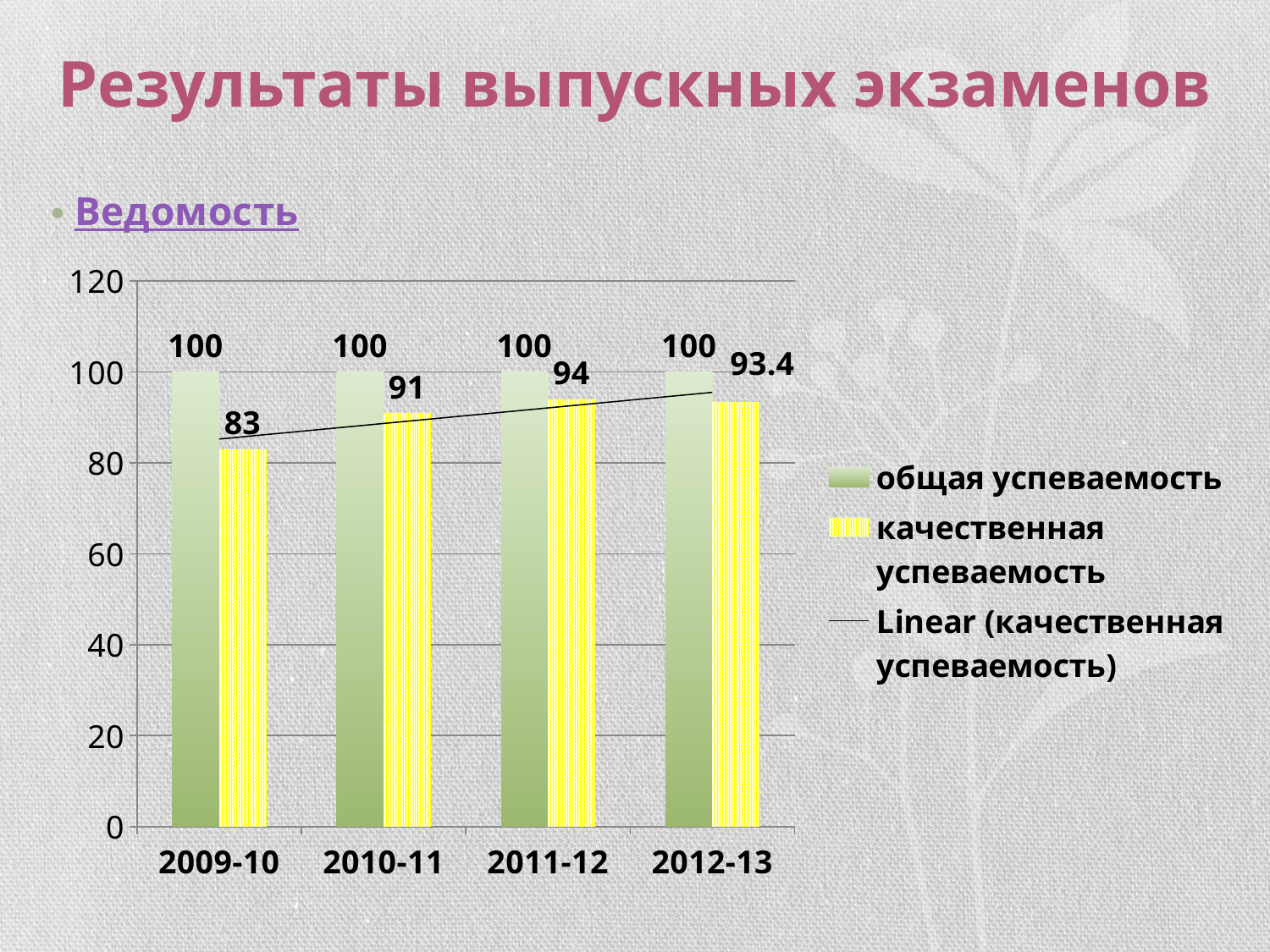
What is the difference between общая успеваемость and качественная успеваемость in 2009-10? 17 What is the value of качественная успеваемость for 2009-10? 83 What is the value of качественная успеваемость for 2012-13? 93.4 How many entries does the legend list? 3 In which year is качественная успеваемость the lowest? 2009-10 Which is larger: качественная успеваемость in 2011-12 or in 2012-13? 2011-12 What is the value of качественная успеваемость for 2010-11? 91 In which year is качественная успеваемость the highest? 2011-12 How many year categories are shown on the x axis? 4 Is the value of качественная успеваемость for 2010-11 greater or less than 80? greater What type of chart is shown on the slide? bar chart What is the value of общая успеваемость for 2011-12? 100